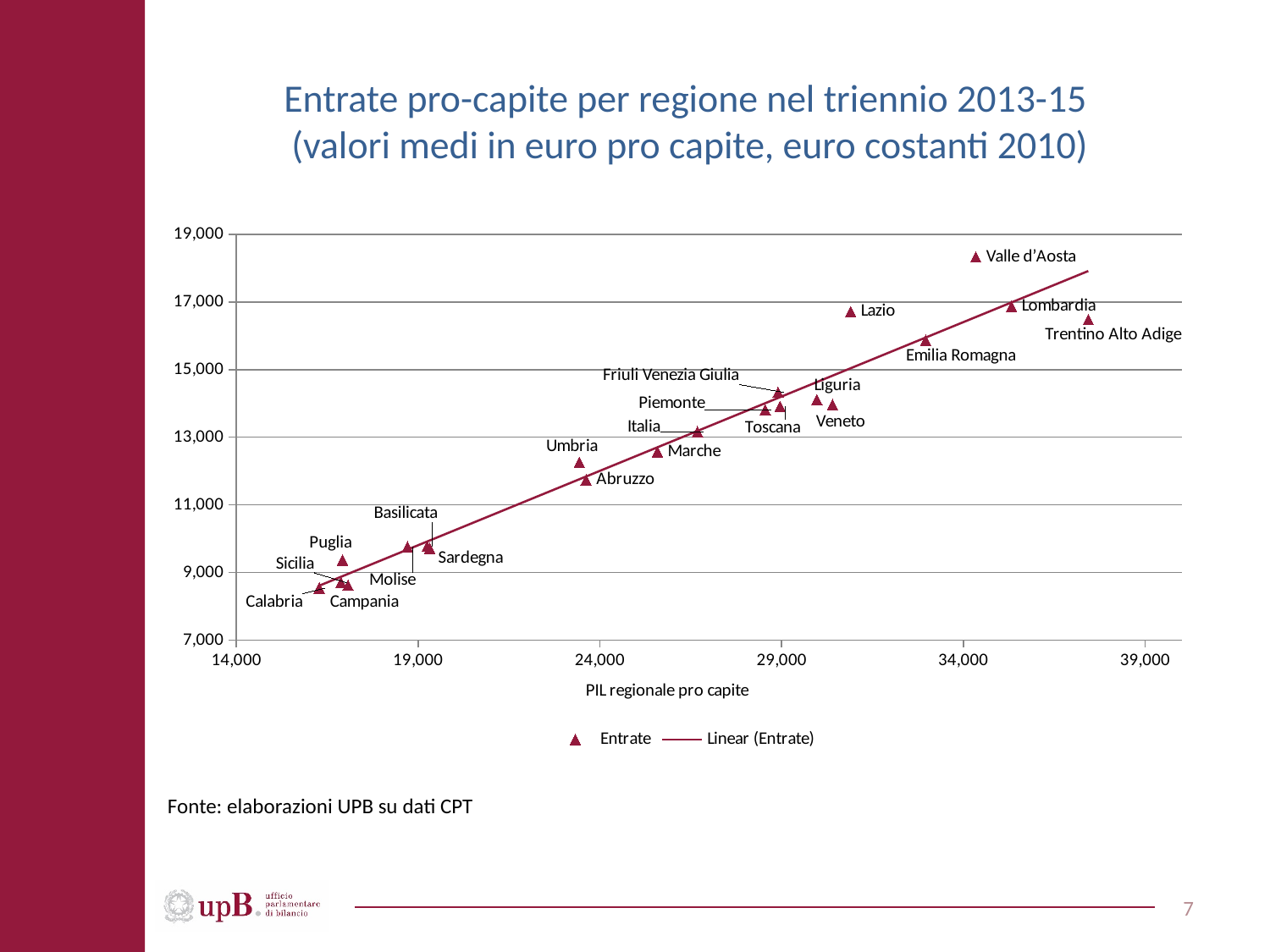
What is the title of the x axis? PIL regionale pro capite Which region has the highest entrate pro-capite value in the chart? Valle d'Aosta Do the entrate values generally rise or fall as PIL regionale pro capite increases along the x axis? rise Which has the higher entrate value, Lazio or Emilia Romagna? Lazio What kind of chart is shown on the slide? scatter chart Is the entrate value for Valle d'Aosta greater or less than 17,000? greater Is the PIL regionale pro capite for Trentino Alto Adige greater or less than 34,000? greater How many entries does the legend list? 2 Is the entrate value for Abruzzo greater or less than 11,000? greater Which has the higher entrate value, Valle d'Aosta or Lombardia? Valle d'Aosta